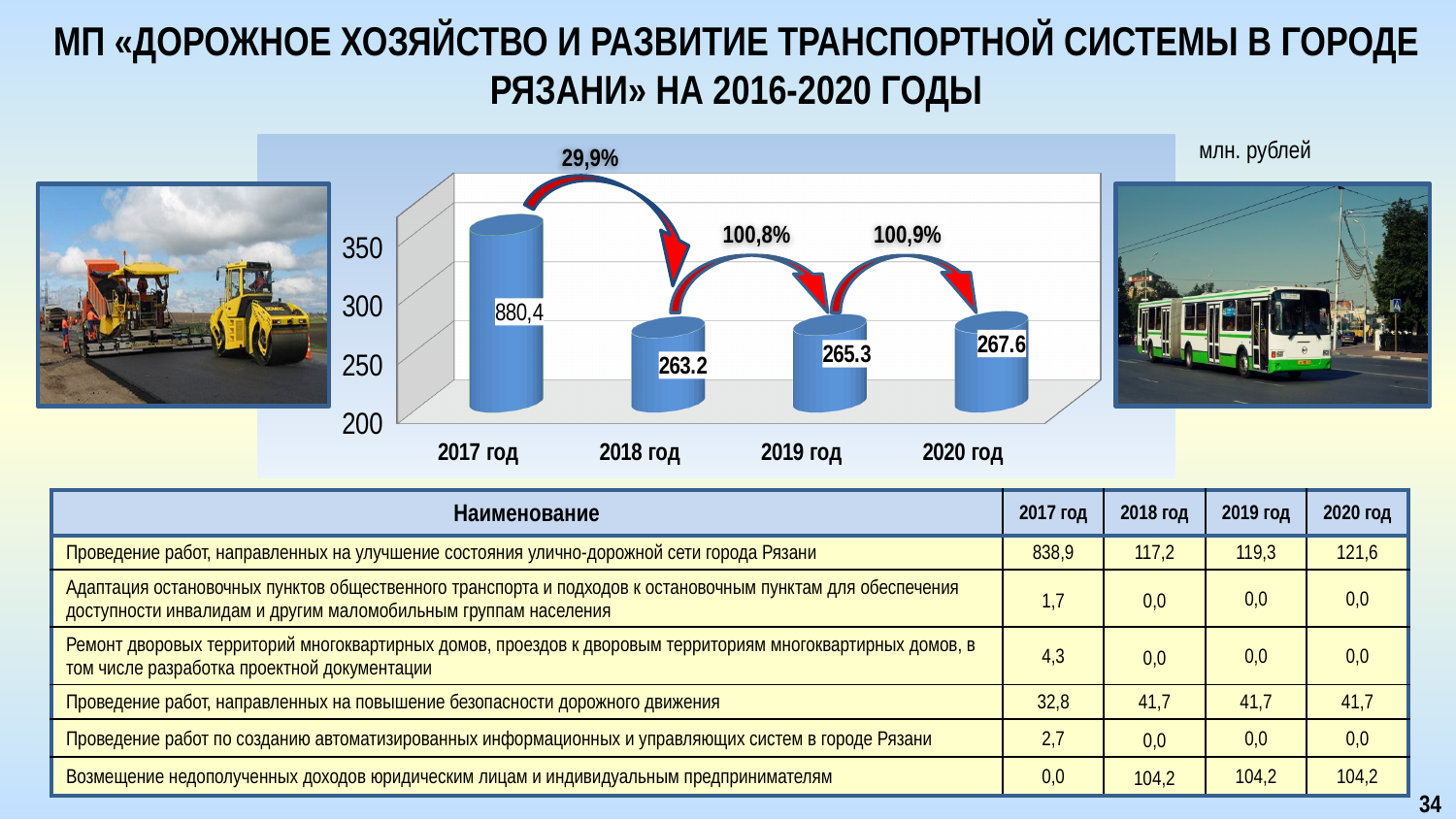
Which is larger, the value for 2019 год or the value for 2020 год? 2020 год What is the value for 2018 год on the chart? 263.2 What kind of chart is shown on the slide? bar chart What unit is indicated for the chart values? млн. рублей What is the value for 2017 год on the chart? 880,4 What is the value for 2020 год on the chart? 267.6 Do the values rise or fall from 2018 год to 2020 год? rise Is the value for 2018 год greater or less than 300? less Which year has the highest value on the chart? 2017 год Which year has the lowest value on the chart? 2018 год How many years are shown on the x axis of the chart? 4 What is the difference between the values for 2020 год and 2018 год? 4.4